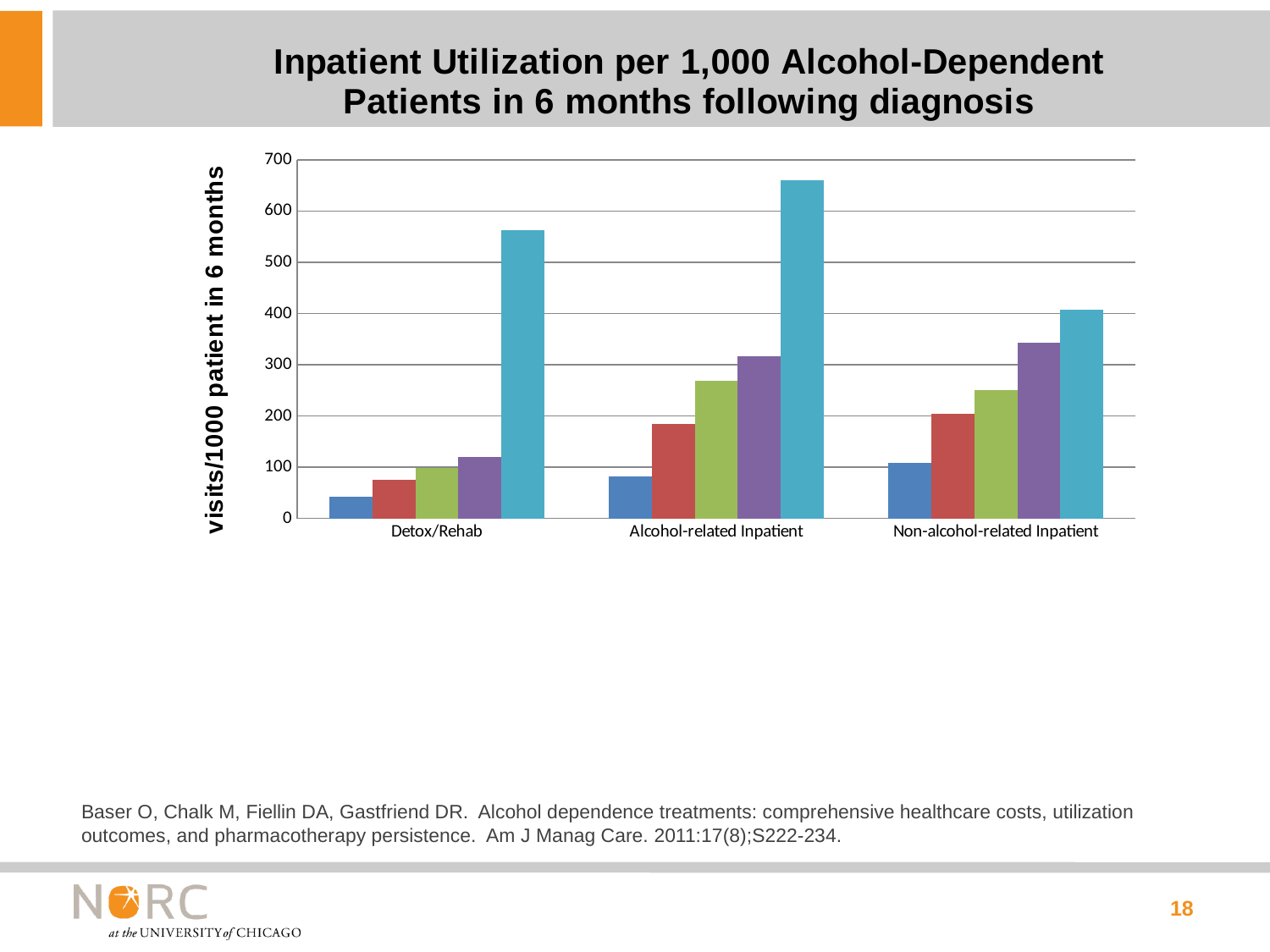
What kind of chart is shown on the slide? bar chart Is the value of the tallest (light blue) bar for Detox/Rehab greater or less than 500? greater How many bars are plotted for each category? 5 Is the value of the dark blue bar for Detox/Rehab greater or less than 100? less Which category contains the shortest bar in the chart? Detox/Rehab How many categories are shown on the x axis? 3 Is the value of the purple bar for Non-alcohol-related Inpatient greater or less than 300? greater Is the light blue bar larger for Alcohol-related Inpatient or for Detox/Rehab? Alcohol-related Inpatient Which category contains the tallest bar in the chart? Alcohol-related Inpatient What is the label on the y axis of the chart? visits/1000 patient in 6 months